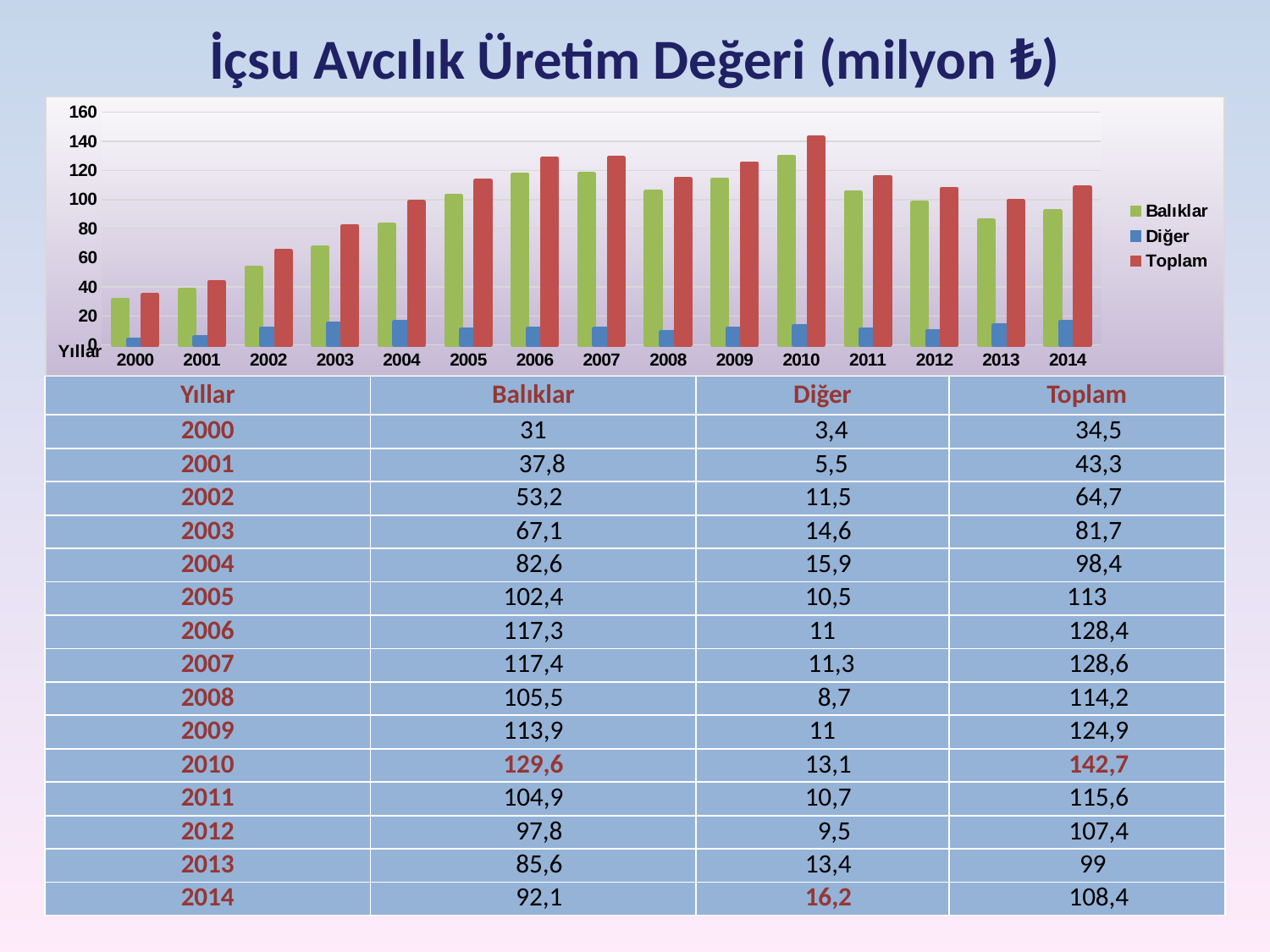
How many years are shown on the x axis of the chart? 15 Which year has the lowest Balıklar value? 2000 What is the Toplam value for 2005? 113 Which is larger, the Balıklar value for 2004 or for 2003? 2004 What is the Diğer value for 2014? 16,2 Do the Balıklar values rise or fall from 2000 to 2006? rise What is the Balıklar value for 2010? 129,6 What is the difference between the Toplam values for 2010 and 2000? 108,2 Which year has the highest Toplam value? 2010 How many series does the legend list? 3 What kind of chart is shown on the slide? bar chart Is the Toplam value for 2010 greater or less than 140? greater